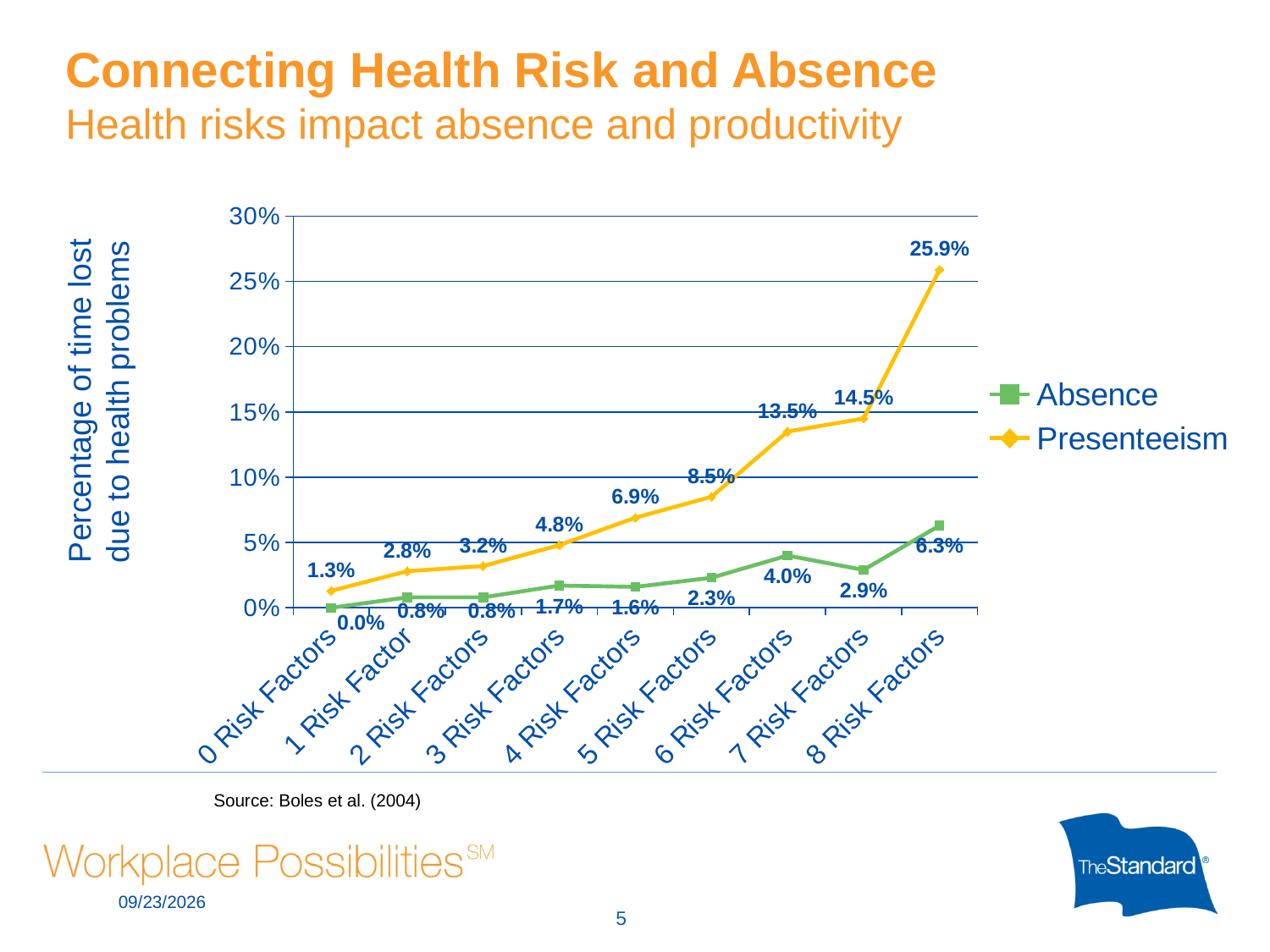
Which category has the lowest Absence value? 0 Risk Factors How many categories are shown on the x axis? 9 Does the Presenteeism series rise or fall as the number of risk factors increases? Rises Which is larger, the Absence value for 6 Risk Factors or the Absence value for 7 Risk Factors? 6 Risk Factors What is the difference between the Presenteeism and Absence values for 8 Risk Factors? 19.6% What is the Presenteeism value for 4 Risk Factors? 6.9% How many series does the legend list? 2 What kind of chart is shown on the slide? Line chart What is the Presenteeism value for 8 Risk Factors? 25.9% What is the Absence value for 6 Risk Factors? 4.0% Which category has the highest Presenteeism value? 8 Risk Factors What is the Absence value for 0 Risk Factors? 0.0%